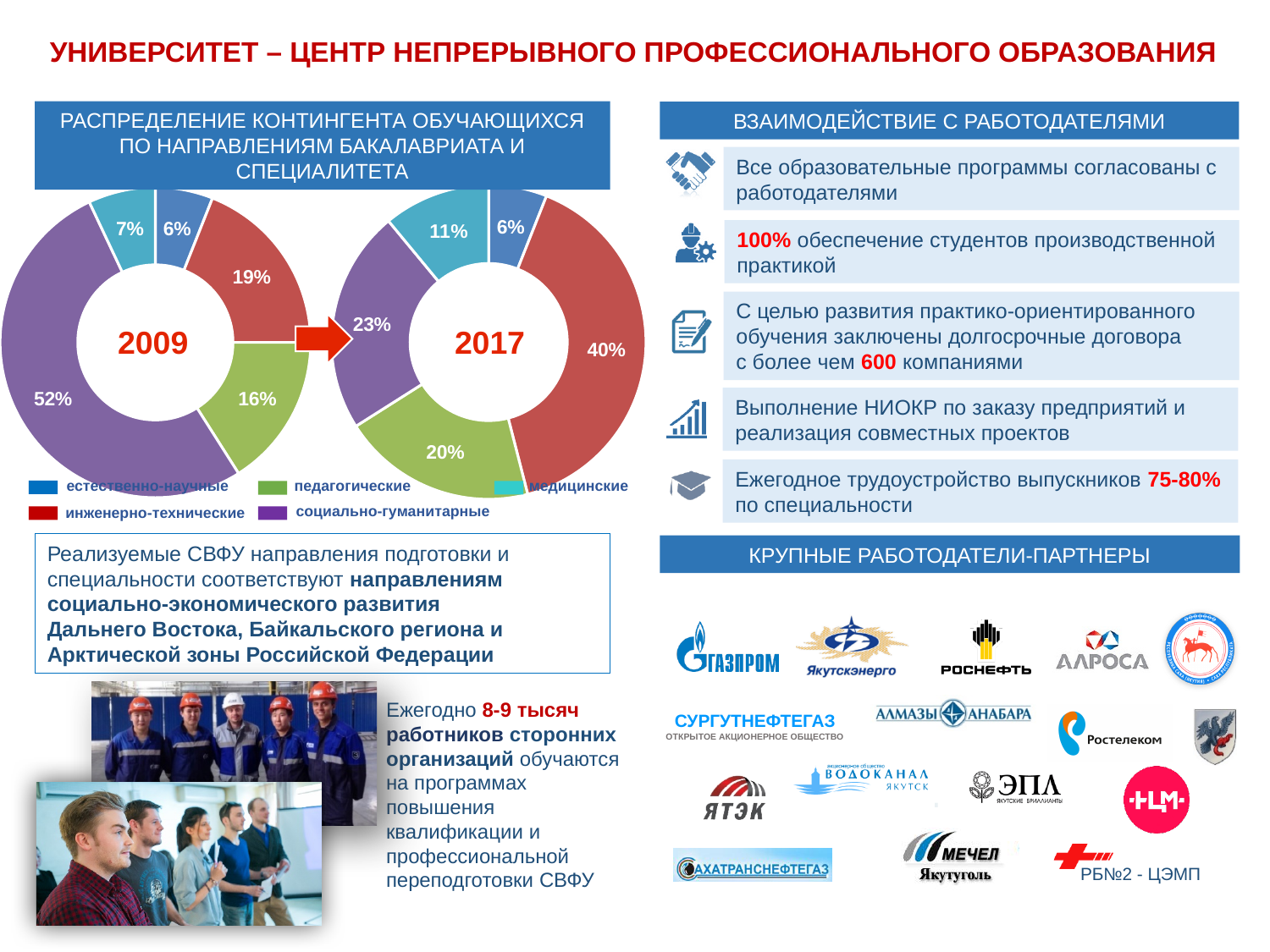
In the 2017 chart, what share do педагогические programmes have? 20% What kind of chart is used to show the distribution of students in 2009 and 2017? Donut (pie) chart In the 2017 chart, which category has the smallest share? естественно-научные In the 2017 chart, what share do инженерно-технические programmes have? 40% In the 2009 chart, what share do социально-гуманитарные programmes have? 52% By how many percentage points did the share of инженерно-технические programmes change from 2009 to 2017? 21 percentage points (19% to 40%) In the 2009 chart, which category has the largest share? социально-гуманитарные Which is larger in the 2017 chart: the share of социально-гуманитарные or педагогические programmes? социально-гуманитарные In the 2009 chart, what share do медицинские programmes have? 7% How many categories does each donut chart show? 5 How many entries does the legend below the donut charts list? 5 Which colour represents инженерно-технические programmes in the donut charts? Red